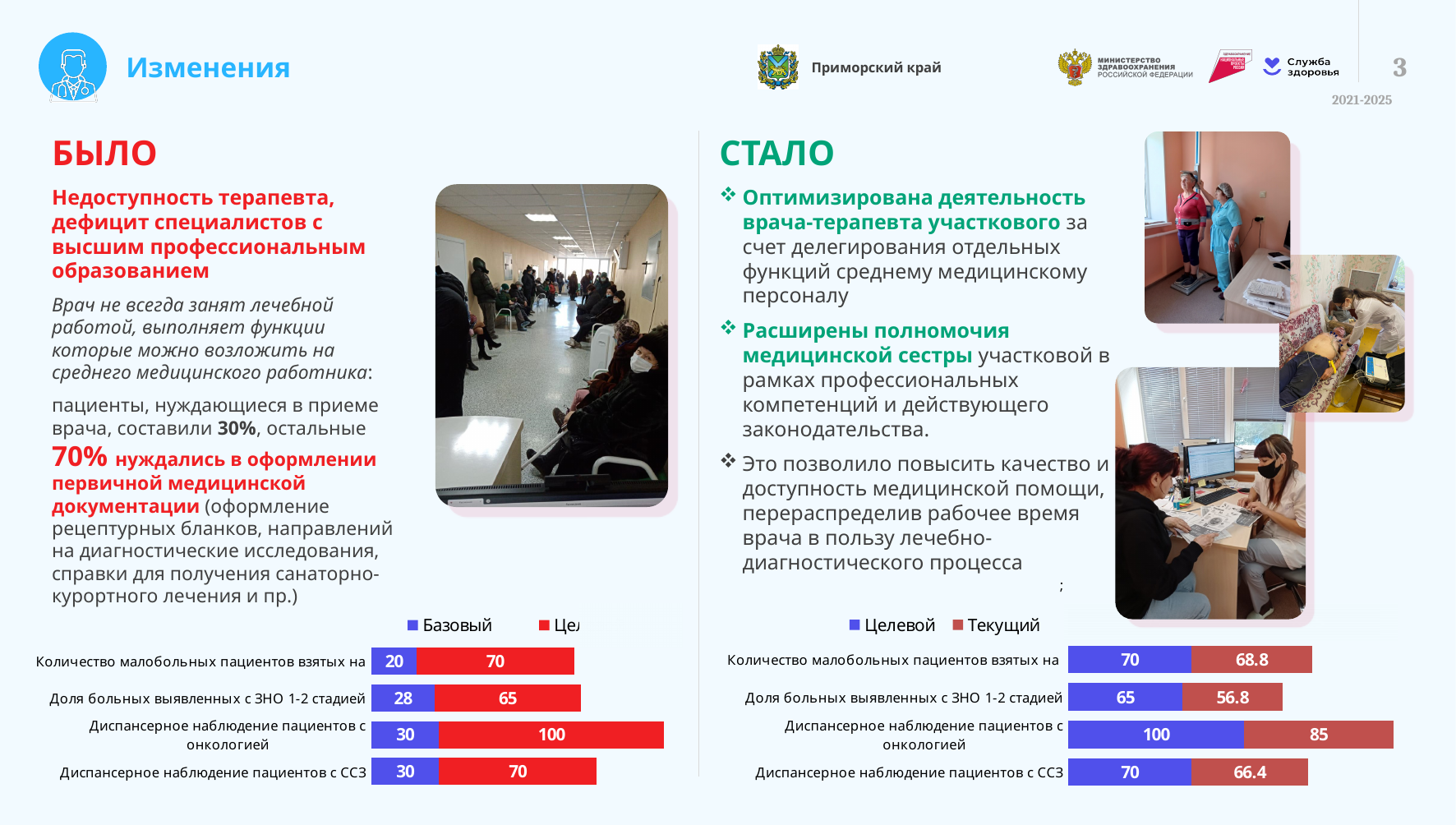
In the right chart (under СТАЛО), which is larger: the Текущий value for Доля больных выявленных с ЗНО 1-2 стадией or for Диспансерное наблюдение пациентов с ССЗ? Диспансерное наблюдение пациентов с ССЗ In the right chart (under СТАЛО), which category has the lowest Текущий value? Доля больных выявленных с ЗНО 1-2 стадией In the right chart (under СТАЛО), what is the Текущий value for Диспансерное наблюдение пациентов с ССЗ? 66.4 In the right chart (under СТАЛО), what is the Целевой value for Доля больных выявленных с ЗНО 1-2 стадией? 65 How many series does the legend of the right chart (under СТАЛО) list? 2 In the left chart (under БЫЛО), what is the total of the stacked bar for Диспансерное наблюдение пациентов с онкологией? 130 In the right chart (under СТАЛО), which category has the highest Текущий value? Диспансерное наблюдение пациентов с онкологией How many categories are shown in the left chart (under БЫЛО)? 4 In the left chart (under БЫЛО), what is the Базовый value for Доля больных выявленных с ЗНО 1-2 стадией? 28 In the right chart (under СТАЛО), what is the Текущий value for Диспансерное наблюдение пациентов с онкологией? 85 In the right chart (under СТАЛО), what is the difference between the Целевой and Текущий values for Диспансерное наблюдение пациентов с онкологией? 15 What kind of chart is the right chart (under СТАЛО)? Bar chart